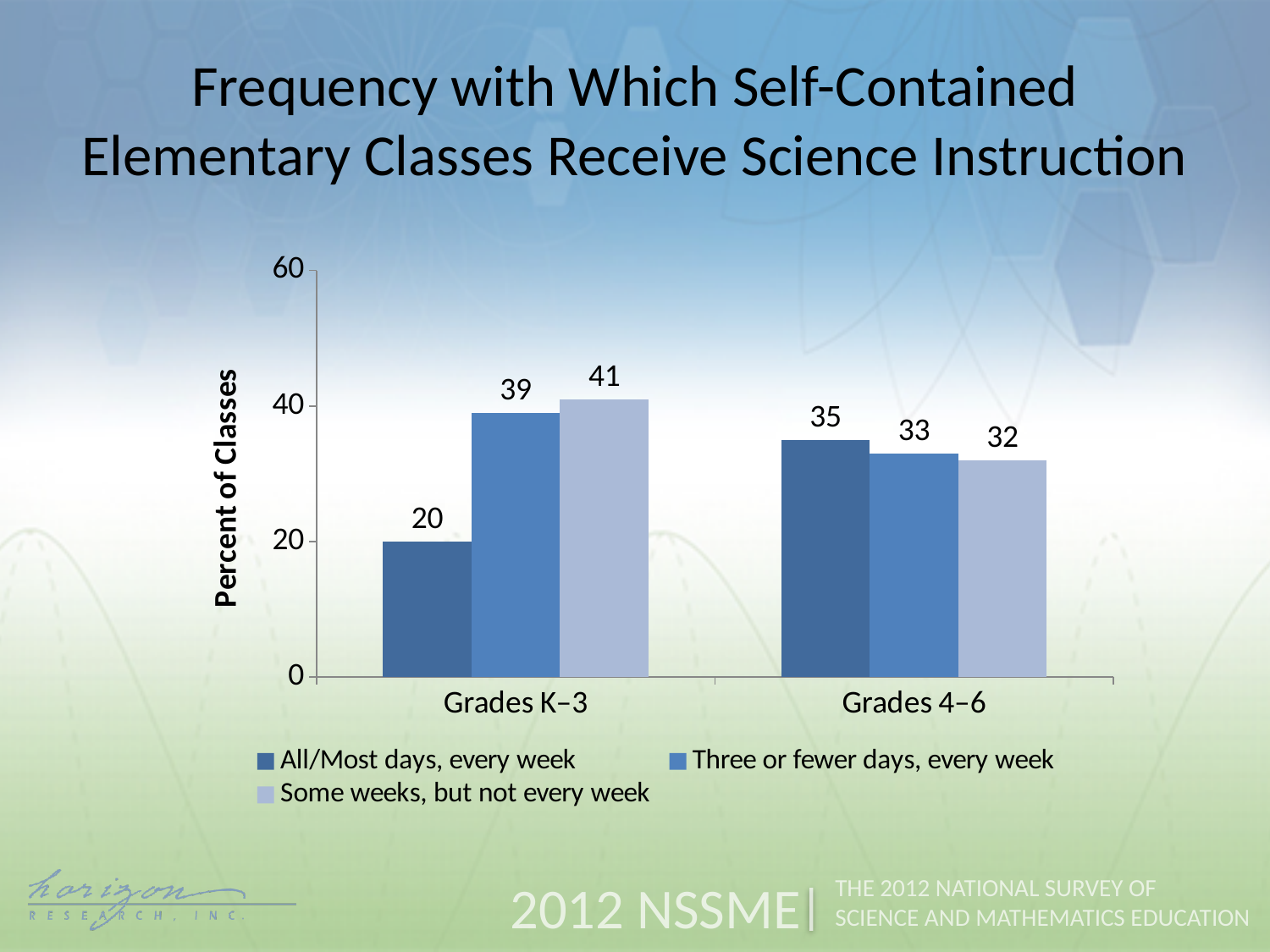
What is the difference between the 'All/Most days, every week' values for Grades 4–6 and Grades K–3? 15 What is the value for 'Some weeks, but not every week' for Grades 4–6? 32 Which frequency category has the highest value for Grades K–3? Some weeks, but not every week What is the difference between the 'Some weeks, but not every week' values for Grades K–3 and Grades 4–6? 9 What kind of chart is shown on the slide? Bar chart How many grade-band categories are shown on the x axis? 2 How many series does the legend list? 3 Which frequency category has the lowest value for Grades 4–6? Some weeks, but not every week Which is larger: 'All/Most days, every week' for Grades K–3 or for Grades 4–6? Grades 4–6 What percent of Grades K–3 classes receive science instruction all/most days, every week? 20 What is the value for 'Three or fewer days, every week' for Grades K–3? 39 Is the value for 'Three or fewer days, every week' for Grades 4–6 greater or less than 40? less